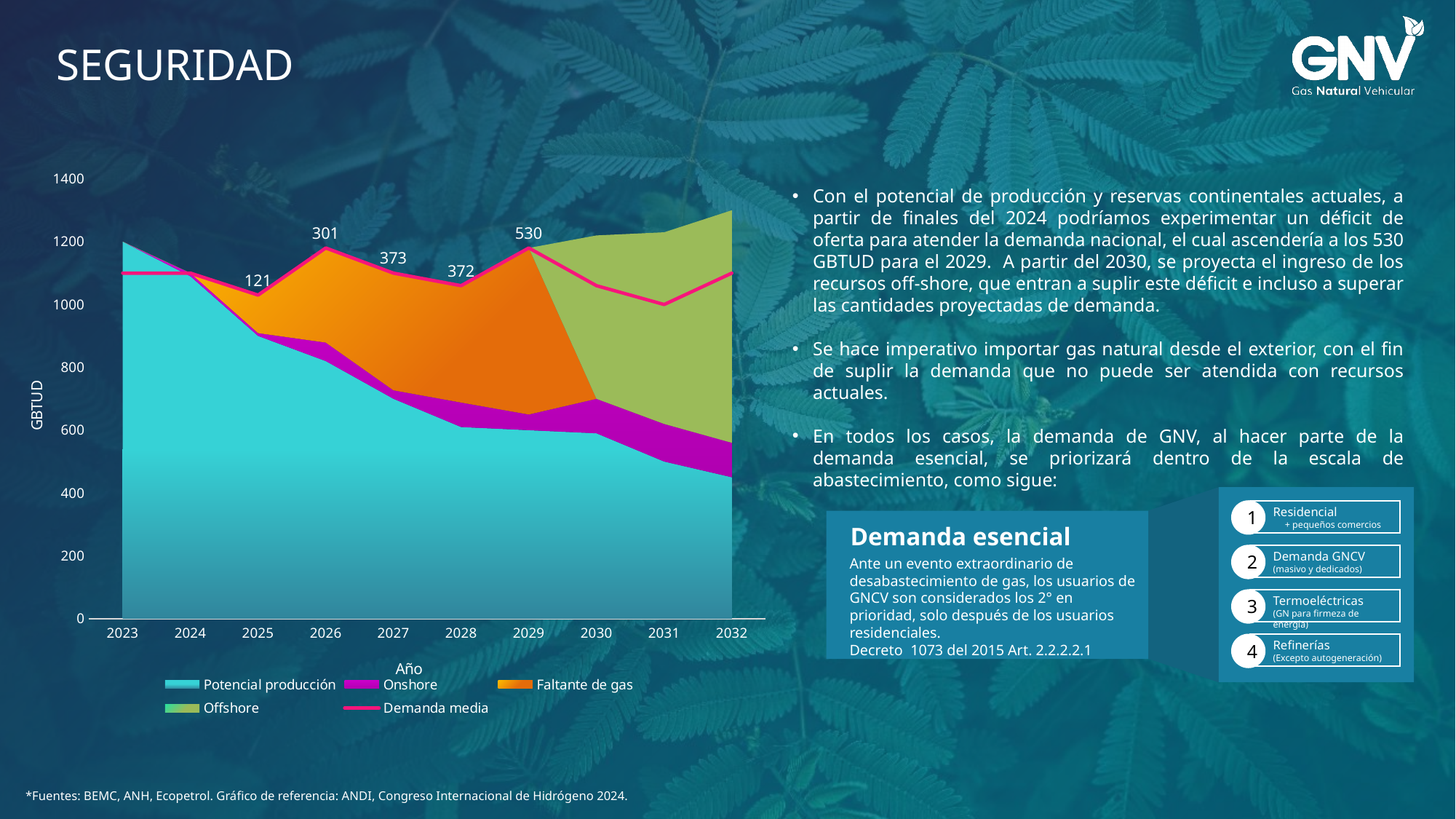
Is the value for Potencial producción in 2023 greater or less than 1000? greater In which year is the labelled Faltante de gas value lowest? 2025 What is the value of Faltante de gas in 2025? 121 What is the difference between the Faltante de gas values for 2027 and 2026? 72 How many series does the chart legend list? 5 In which year is the labelled Faltante de gas value highest? 2029 Which is larger, the Faltante de gas value for 2026 or for 2027? 2027 How many years are shown on the x axis of the chart? 10 What is the value of Faltante de gas in 2027? 373 What kind of chart is shown on the slide? Combination area and line chart (stacked areas with a line for Demanda media) What is the difference between the Faltante de gas values for 2029 and 2028? 158 What is the value of Faltante de gas in 2029? 530